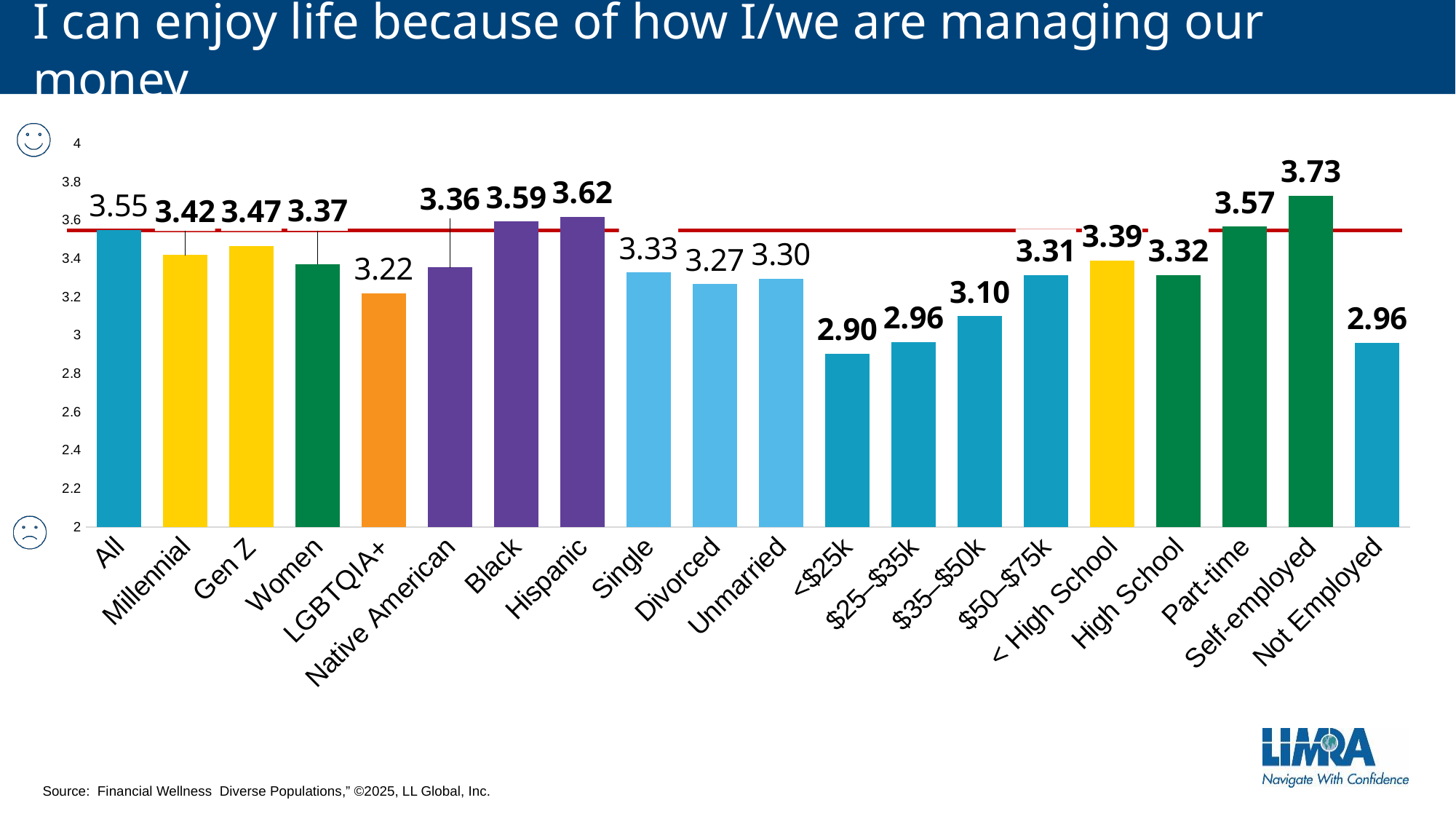
What is the difference between the values for Hispanic and Black? 0.03 Which category has the highest value? Self-employed Which is larger, the value for Gen Z or the value for Millennial? Gen Z What kind of chart is shown on the slide? Bar chart What is the difference between the values for Self-employed and Not Employed? 0.77 Is the value for Divorced greater or less than 3.4? less What is the value for $35–$50k? 3.10 What is the value for LGBTQIA+? 3.22 What is the value for Self-employed? 3.73 How many categories are shown on the x axis? 20 Which category has the lowest value? <$25k What is the value for the All category? 3.55